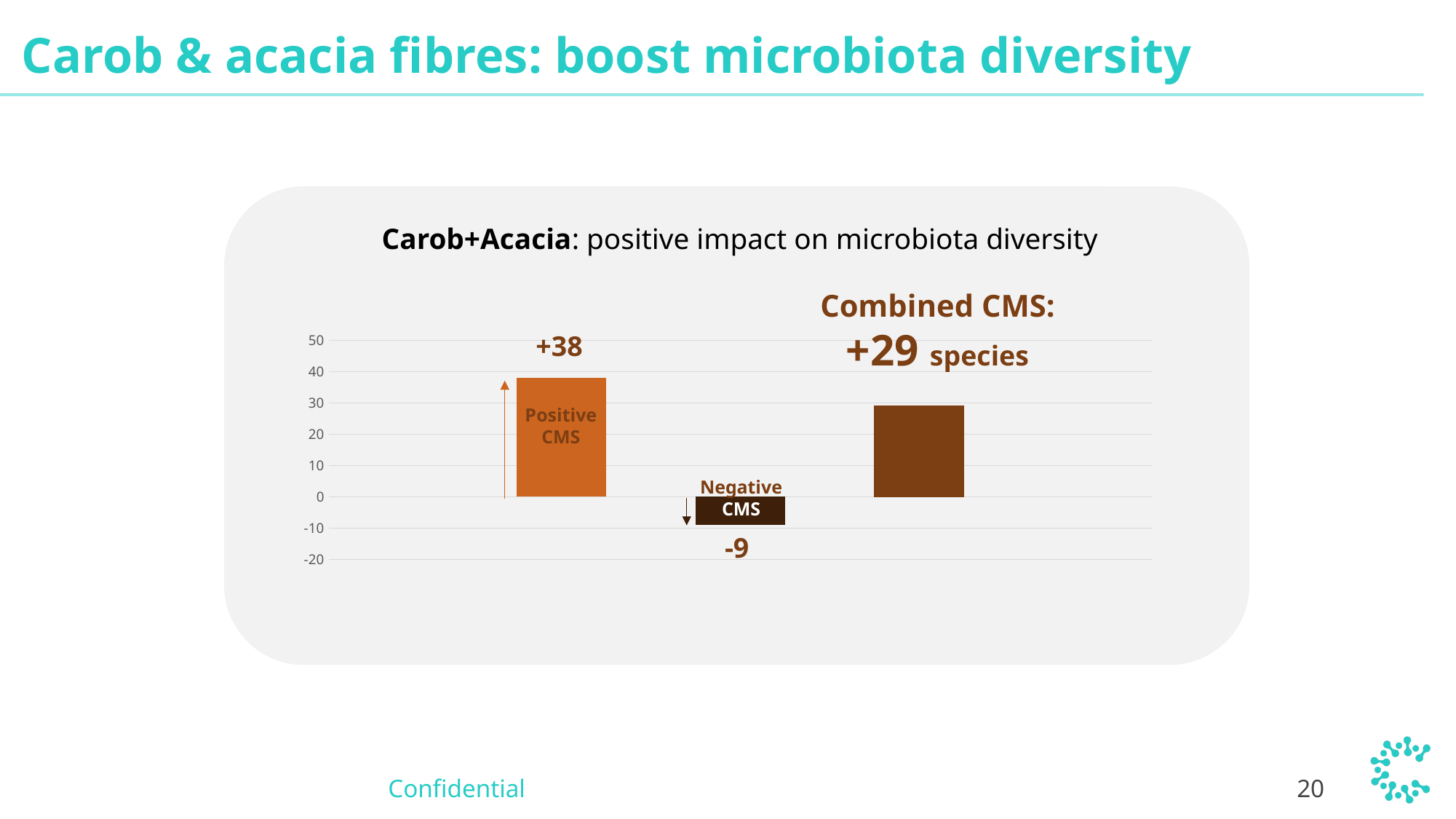
Is the value for Negative CMS greater or less than 0? less What is the title of the chart? Carob+Acacia: positive impact on microbiota diversity What is the value for Combined CMS? +29 species Which is larger, the Positive CMS bar or the Combined CMS bar? Positive CMS Which bar is the lowest? Negative CMS Is the value for Positive CMS greater or less than 30? greater What is the value for Positive CMS? +38 Which bar is the highest? Positive CMS What is the value for Negative CMS? -9 What kind of chart is shown? bar chart What is the difference between the Positive CMS value and the Combined CMS value? 9 How many bars are plotted in the chart? 3